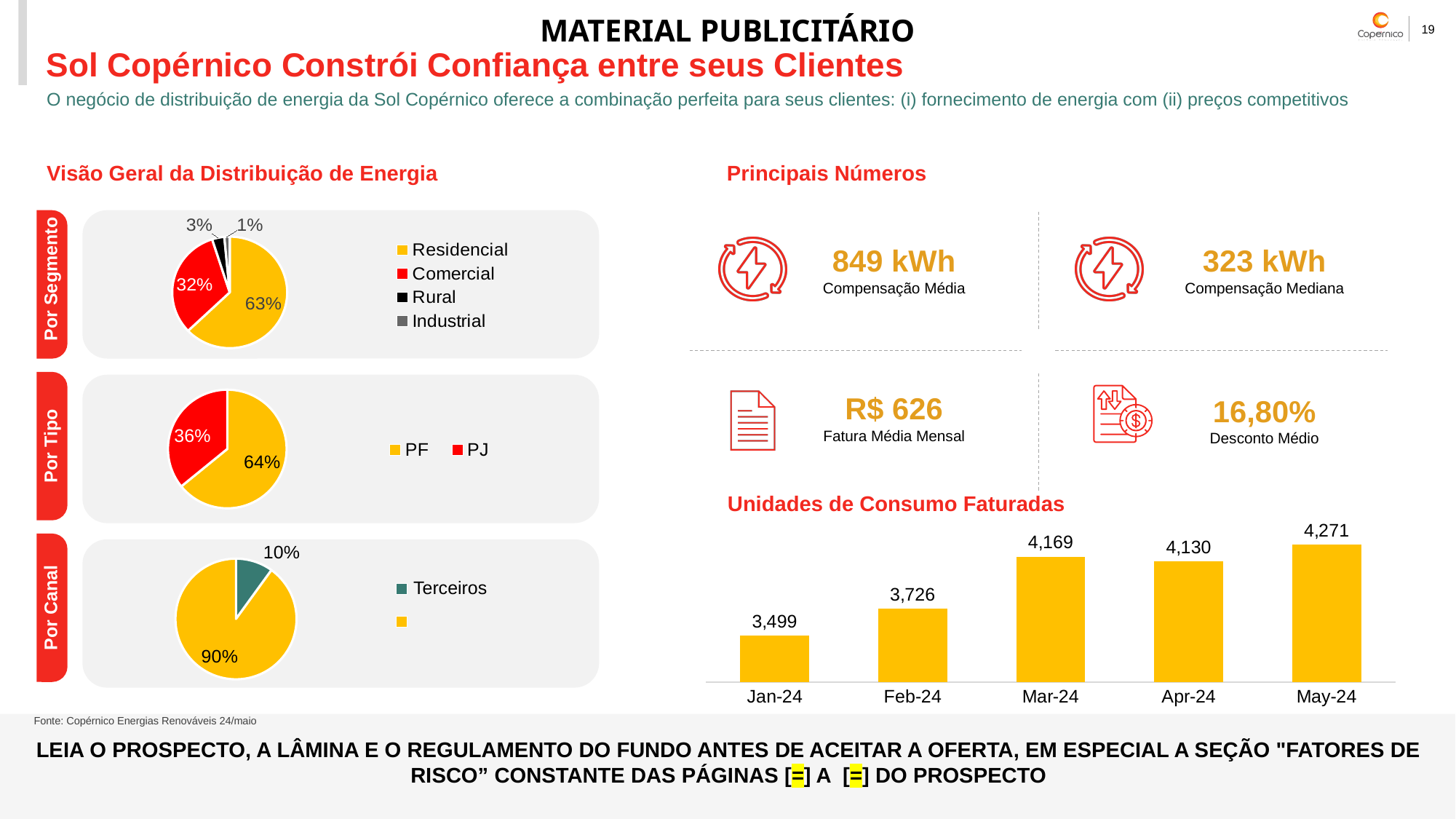
In the 'Unidades de Consumo Faturadas' chart, which month has the highest value? May-24 In the 'Unidades de Consumo Faturadas' chart, what is the value for Mar-24? 4,169 In the 'Por Segmento' pie chart, how many entries does the legend list? 4 In the 'Unidades de Consumo Faturadas' chart, what is the difference between May-24 and Jan-24? 772 What kind of chart is 'Unidades de Consumo Faturadas'? Bar chart In the 'Por Canal' pie chart, what share is Terceiros? 10% In the 'Unidades de Consumo Faturadas' chart, which month has the lowest value? Jan-24 In the 'Por Tipo' pie chart, what share is PJ? 36% In the 'Unidades de Consumo Faturadas' chart, which is larger, Mar-24 or Apr-24? Mar-24 In the 'Por Segmento' pie chart, what share is Residencial? 63% In the 'Por Segmento' pie chart, which segment has the largest share? Residencial In the 'Por Segmento' pie chart, which segment has the smallest share? Industrial